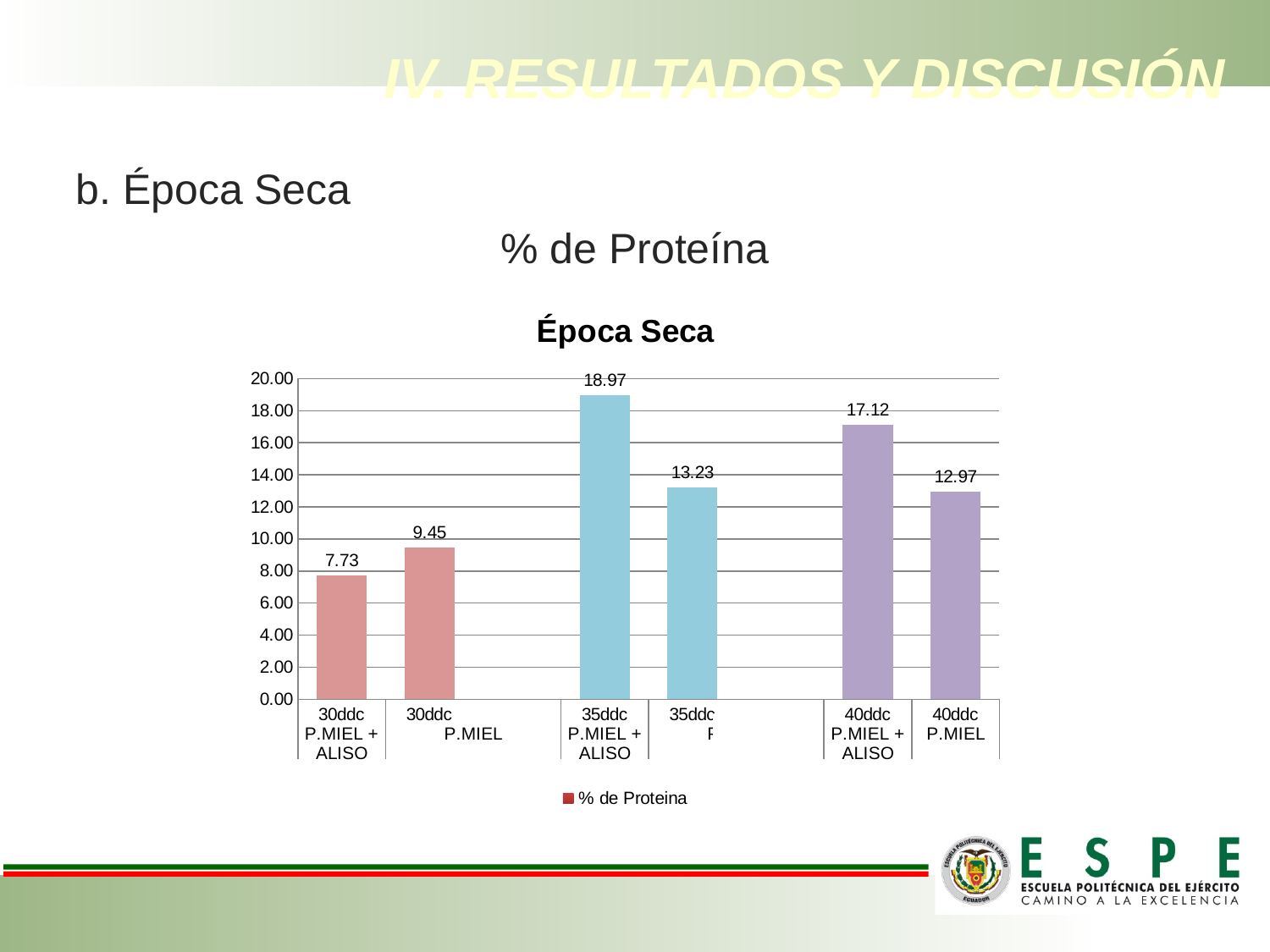
Which is larger, the value for 30ddc P.MIEL or the value for 30ddc P.MIEL + ALISO? 30ddc P.MIEL Which category has the highest % de Proteina value? 35ddc P.MIEL + ALISO What is the % de Proteina value for 40ddc P.MIEL? 12.97 What is the % de Proteina value for 35ddc P.MIEL + ALISO? 18.97 What is the difference between the % de Proteina values for 40ddc P.MIEL + ALISO and 40ddc P.MIEL? 4.15 What is the % de Proteina value for 30ddc P.MIEL + ALISO? 7.73 How many bars are plotted in the chart? 6 Which category has the lowest % de Proteina value? 30ddc P.MIEL + ALISO What type of chart is shown on the slide? bar chart What is the title of the chart? Época Seca What is the % de Proteina value for 30ddc P.MIEL? 9.45 What is the % de Proteina value for 40ddc P.MIEL + ALISO? 17.12